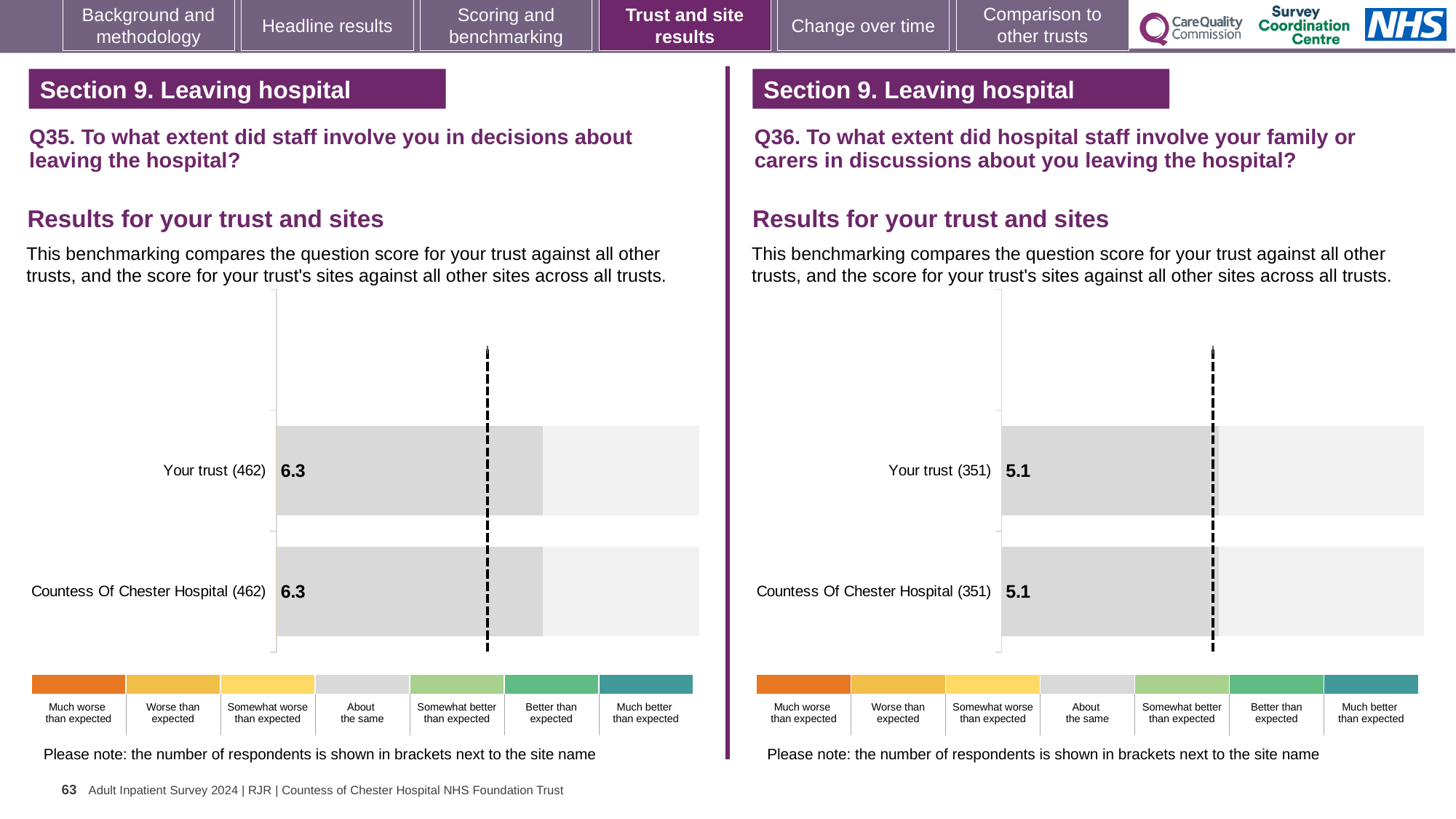
How many bars are plotted on the Q36 chart (right)? 2 On the Q36 chart (right), what is the score for Countess Of Chester Hospital? 5.1 On the Q35 chart (left), what is the score for Your trust? 6.3 Is the score for Your trust on the Q35 chart (left) larger or smaller than the score for Your trust on the Q36 chart (right)? Larger On the Q36 chart (right), how many respondents are shown in brackets next to Countess Of Chester Hospital? 351 How many bars are plotted on the Q35 chart (left)? 2 On the Q35 chart (left), how many respondents are shown in brackets next to Your trust? 462 On the Q36 chart (right), what is the score for Your trust? 5.1 What kind of chart is used on the Q35 chart (left)? Bar chart On the Q35 chart (left), what is the difference between the score for Your trust and the score for Countess Of Chester Hospital? 0 On the Q36 chart (right), what is the difference between the score for Your trust and the score for Countess Of Chester Hospital? 0 On the Q35 chart (left), what is the score for Countess Of Chester Hospital? 6.3